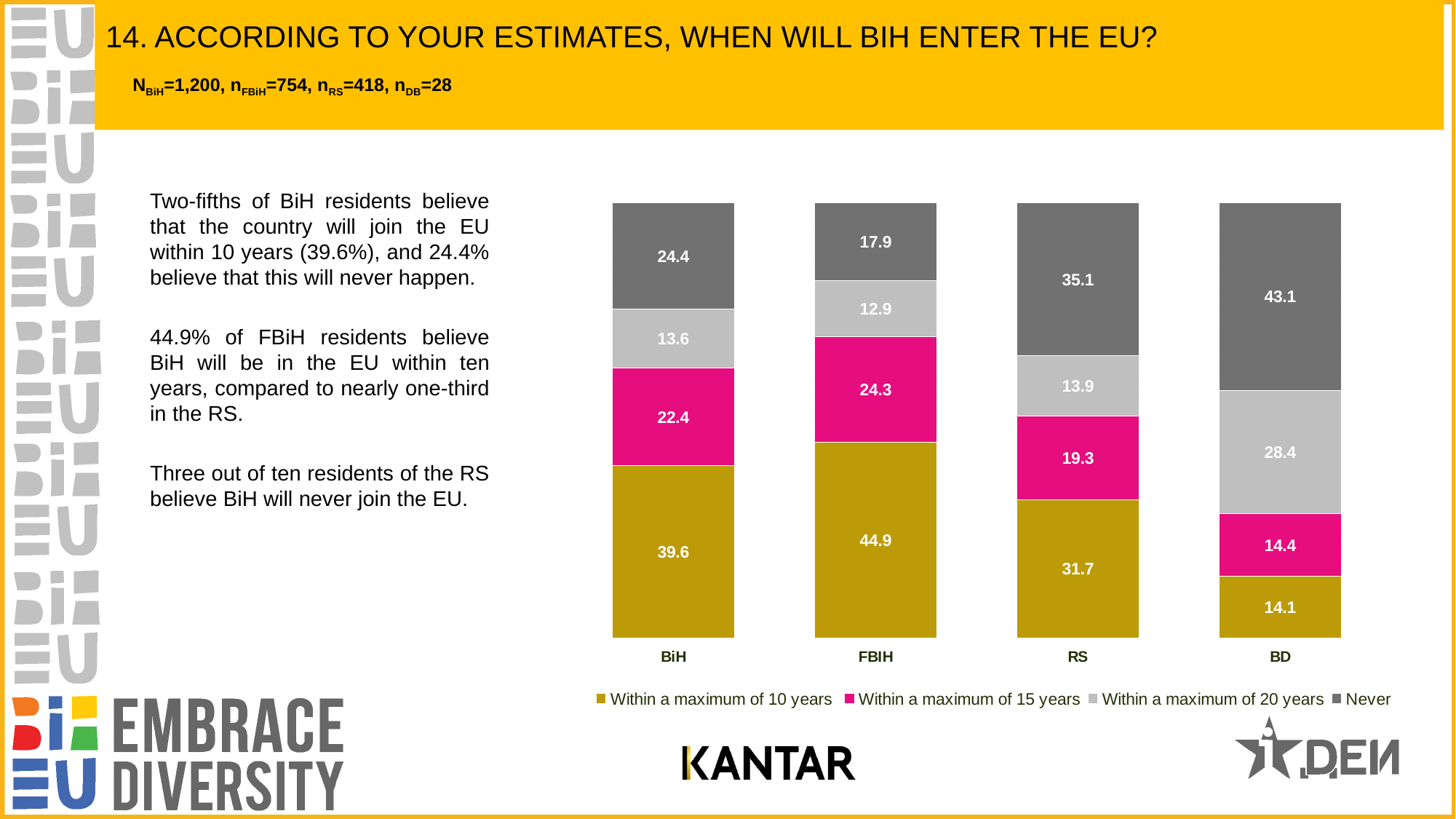
What is the difference between the "Never" values for BD and FBIH? 25.2 What is the value for "Within a maximum of 10 years" for BiH? 39.6 How many categories are shown on the x axis? 4 How many series does the legend list? 4 Which category has the lowest value for "Within a maximum of 10 years"? BD What is the value for "Within a maximum of 15 years" for FBIH? 24.3 What is the value for "Within a maximum of 20 years" for BD? 28.4 Which category has the highest value for "Never"? BD What kind of chart is shown on the slide? Stacked bar chart What is the value for "Never" for RS? 35.1 What is the total of the stacked bar for RS? 100.0 Which is larger: the "Within a maximum of 10 years" value for FBIH or for RS? FBIH